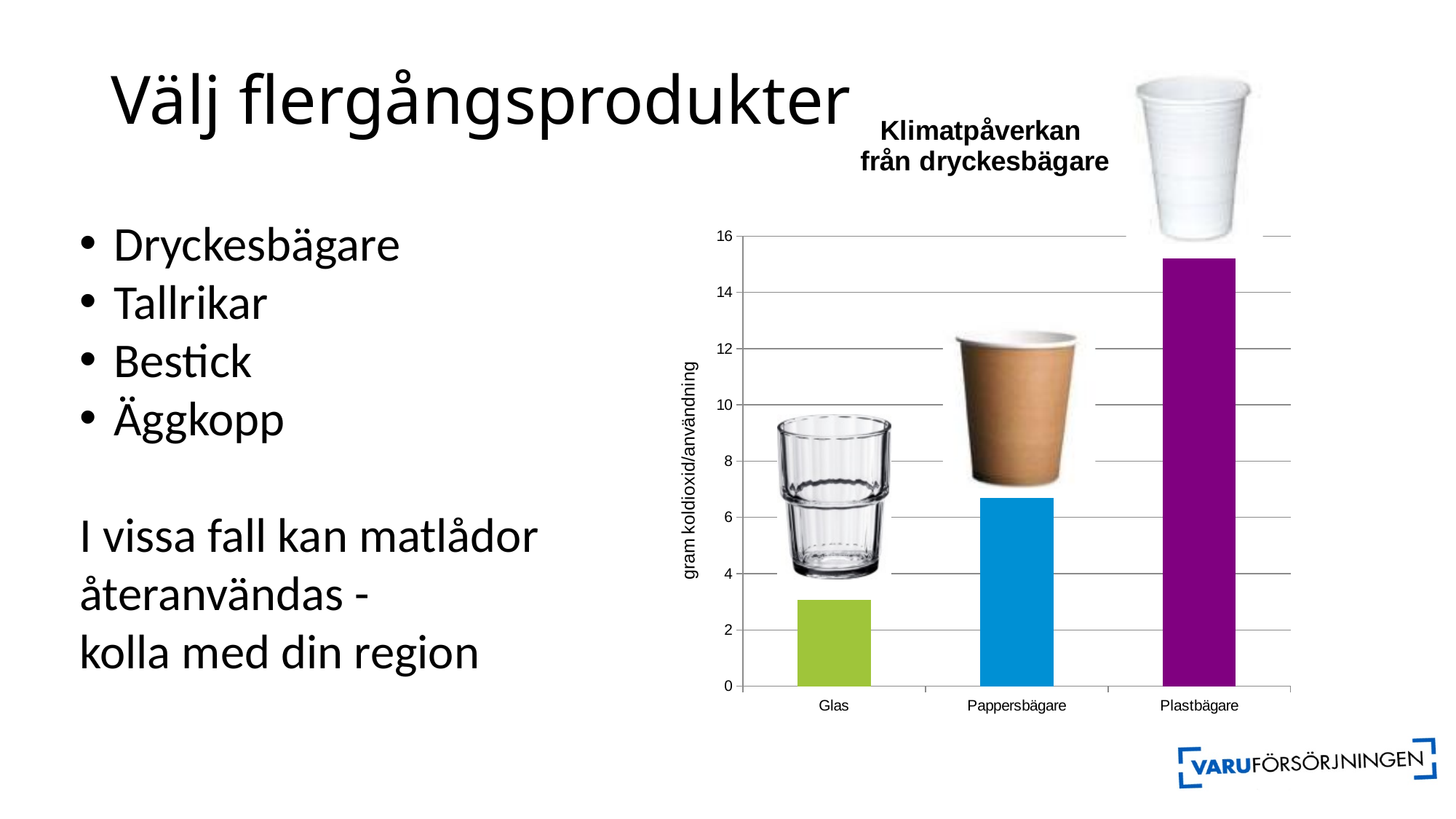
How many categories are shown on the x axis of the chart? 3 Do the values rise or fall from left to right along the x axis? rise What kind of chart is shown on the slide? bar chart Is the value for Glas greater or less than 4? less Which has a larger value, Plastbägare or Pappersbägare? Plastbägare Is the value for Plastbägare greater or less than 14? greater Is the value for Pappersbägare greater or less than 6? greater Which has a larger value, Pappersbägare or Glas? Pappersbägare Which category has the lowest value in the chart? Glas What is the title of the chart? Klimatpåverkan från dryckesbägare What is the label on the y axis of the chart? gram koldioxid/användning Which category has the highest value in the chart? Plastbägare